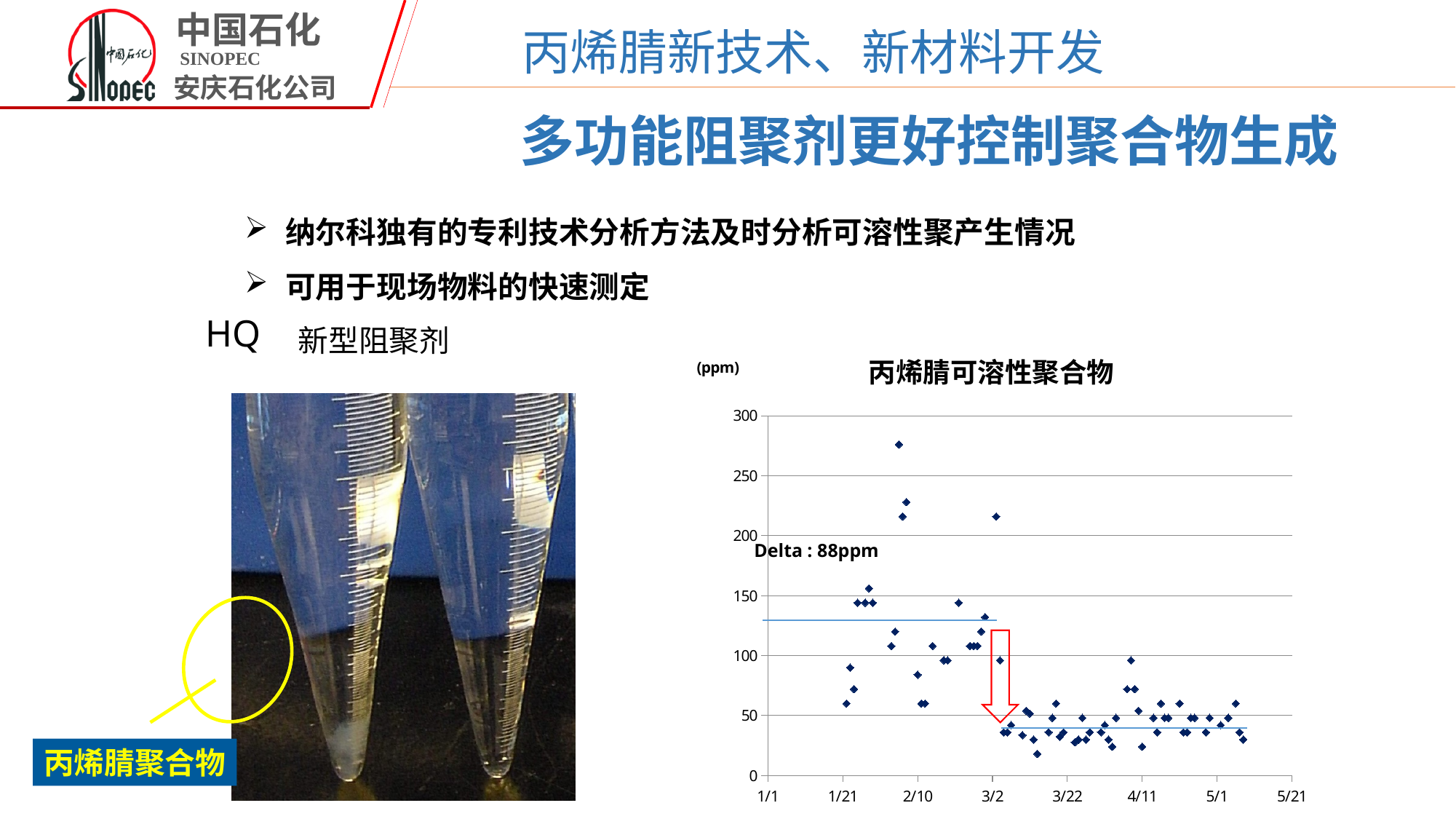
Are the plotted values before 3/2 generally higher or lower than the values after 3/2? higher Is the highest plotted point on the chart greater or less than 250? greater What kind of chart is shown on the slide? scatter chart What is the last date label on the x axis of the chart? 5/21 Are the plotted values after 3/22 greater or less than 100? less What is the title of the chart on the slide? 丙烯腈可溶性聚合物 How many date tick labels are shown on the x axis of the chart? 8 What is the first date label on the x axis of the chart? 1/1 Do the plotted values generally rise or fall from left to right along the x axis? fall What delta value is annotated on the chart? 88ppm What is the maximum value shown on the y axis of the chart? 300 What unit is shown for the y axis of the chart? ppm